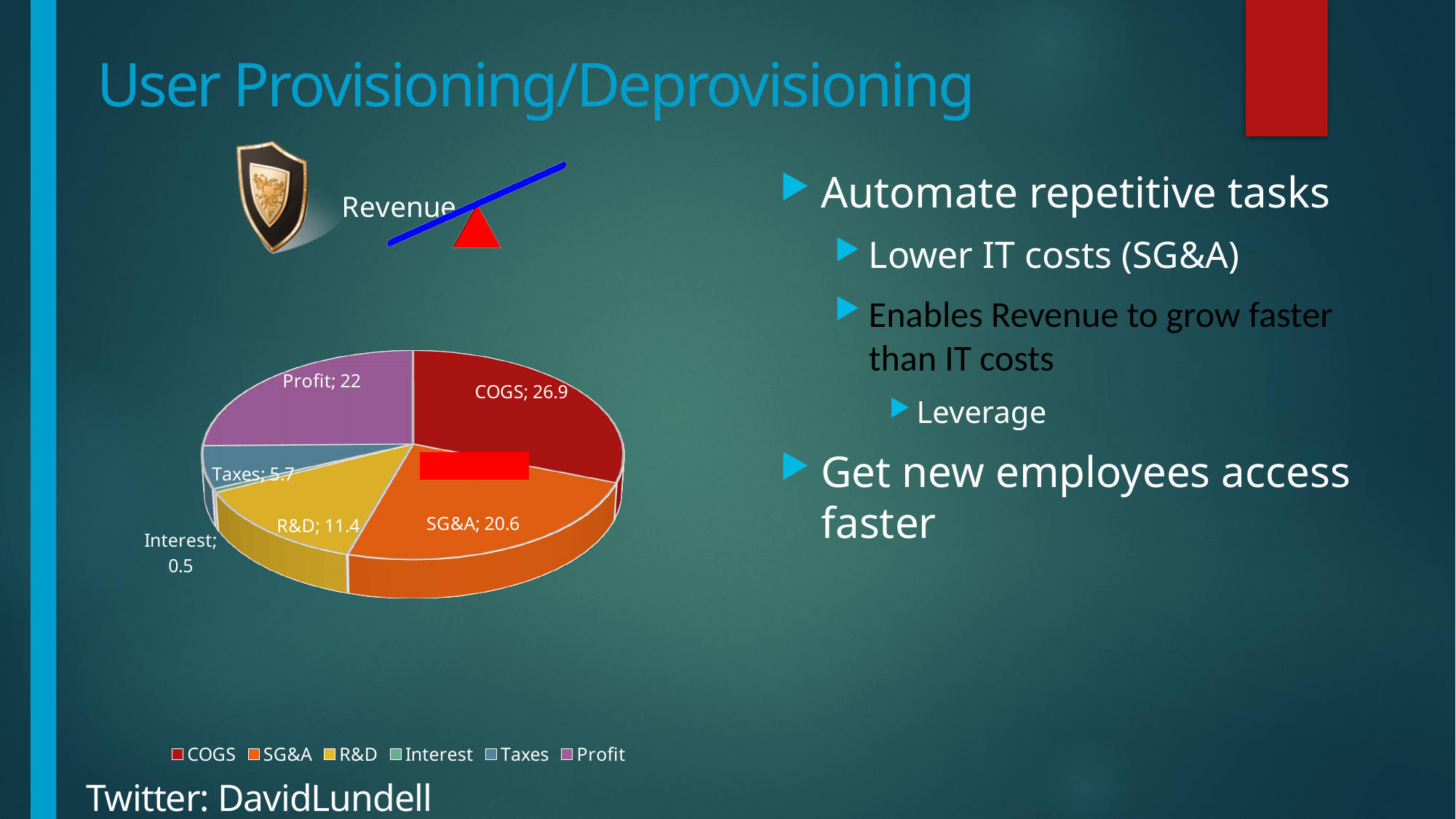
What is the value for COGS in the pie chart? 26.9 What is the value for Interest in the pie chart? 0.5 Which legend entry is shown in purple in the pie chart? Profit Which category has the smallest slice in the pie chart? Interest What is the difference between the COGS and SG&A values in the pie chart? 6.3 What is the difference between the Profit and Taxes values in the pie chart? 16.3 Which category has the largest slice in the pie chart? COGS What kind of chart is shown on the slide? Pie chart How many categories does the pie chart show? 6 What is the value for SG&A in the pie chart? 20.6 What is the value for Profit in the pie chart? 22 Which is larger in the pie chart, R&D or Taxes? R&D